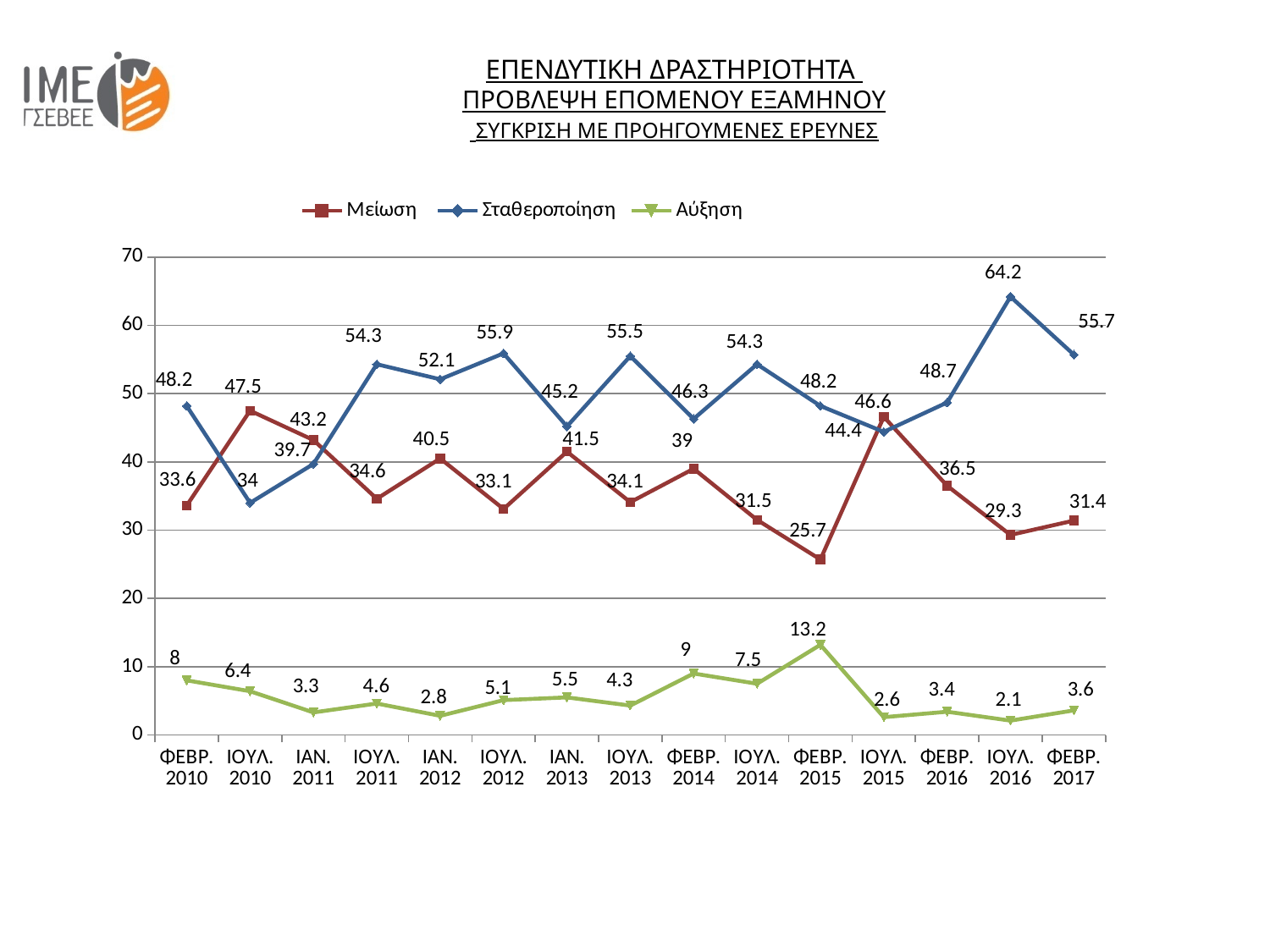
Which series is drawn in green? Αύξηση What type of chart is shown on the slide? Line chart How many survey periods are plotted along the x axis? 15 In ΙΟΥΛ. 2010, which is larger: Μείωση or Σταθεροποίηση? Μείωση In which period does Μείωση reach its lowest value? ΦΕΒΡ. 2015 Is the value of Σταθεροποίηση for ΙΟΥΛ. 2016 greater or less than 60? greater What is the value of Μείωση for ΦΕΒΡ. 2015? 25.7 What is the value of Αύξηση for ΦΕΒΡ. 2017? 3.6 What is the value of Σταθεροποίηση for ΙΟΥΛ. 2016? 64.2 How many series does the legend list? 3 In which period does Αύξηση reach its highest value? ΦΕΒΡ. 2015 What is the difference between Σταθεροποίηση and Μείωση in ΦΕΒΡ. 2017? 24.3